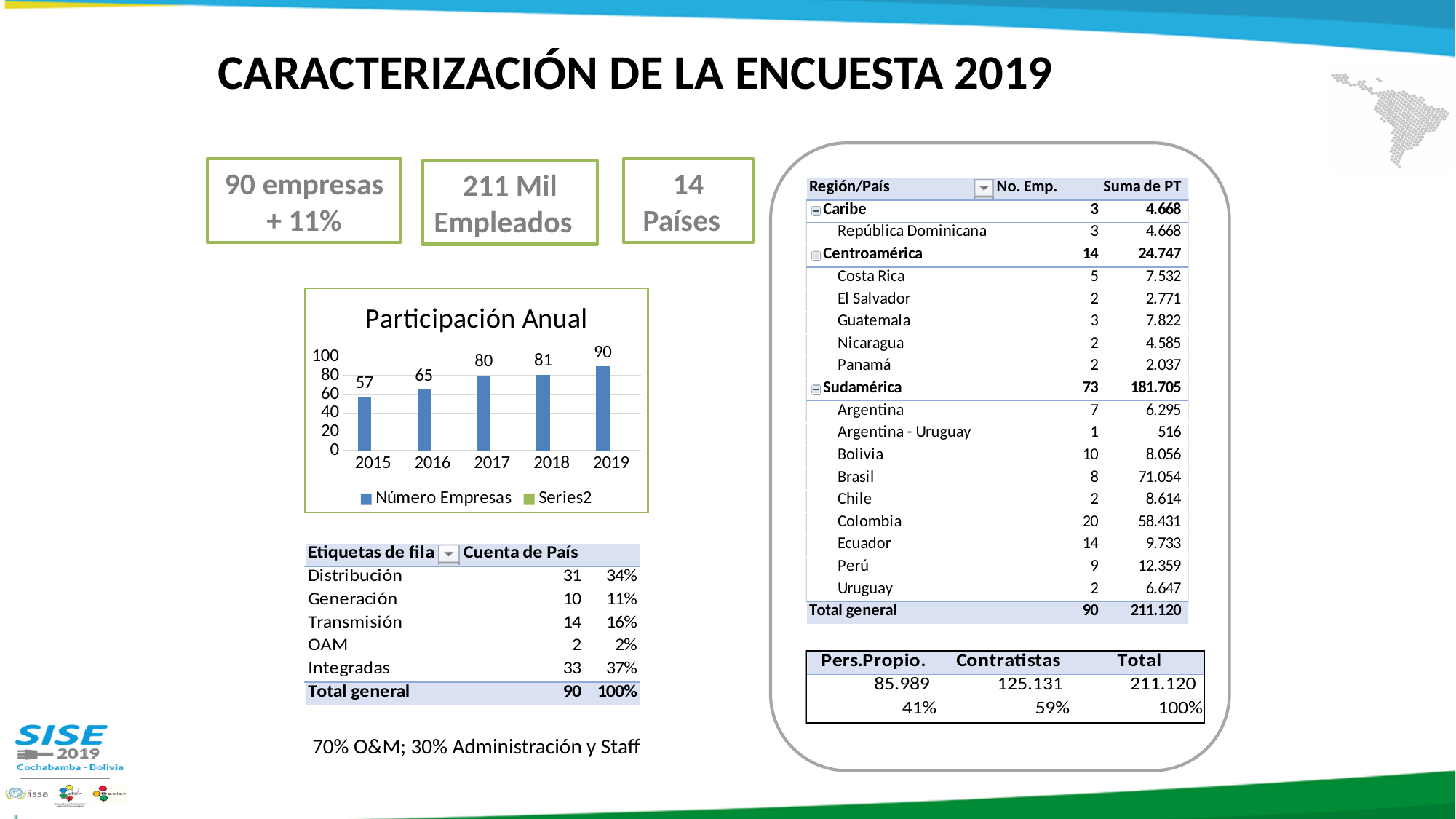
In the 'Participación Anual' chart, which year has the highest value? 2019 In the 'Participación Anual' chart, what is the value for 2019? 90 In the 'Participación Anual' chart, which is larger, the value for 2016 or the value for 2018? 2018 In the 'Participación Anual' chart, what is the value for 2015? 57 In the 'Participación Anual' chart, do the values rise or fall from 2015 to 2019? rise How many series does the legend of the 'Participación Anual' chart list? 2 In the 'Participación Anual' chart, what is the difference between the values for 2019 and 2015? 33 In the 'Participación Anual' chart, what is the value for 2017? 80 In the 'Participación Anual' chart, which year has the lowest value? 2015 In the 'Participación Anual' chart, how many years are shown on the x axis? 5 What type of chart is 'Participación Anual'? bar chart What is the title of the chart on the slide? Participación Anual